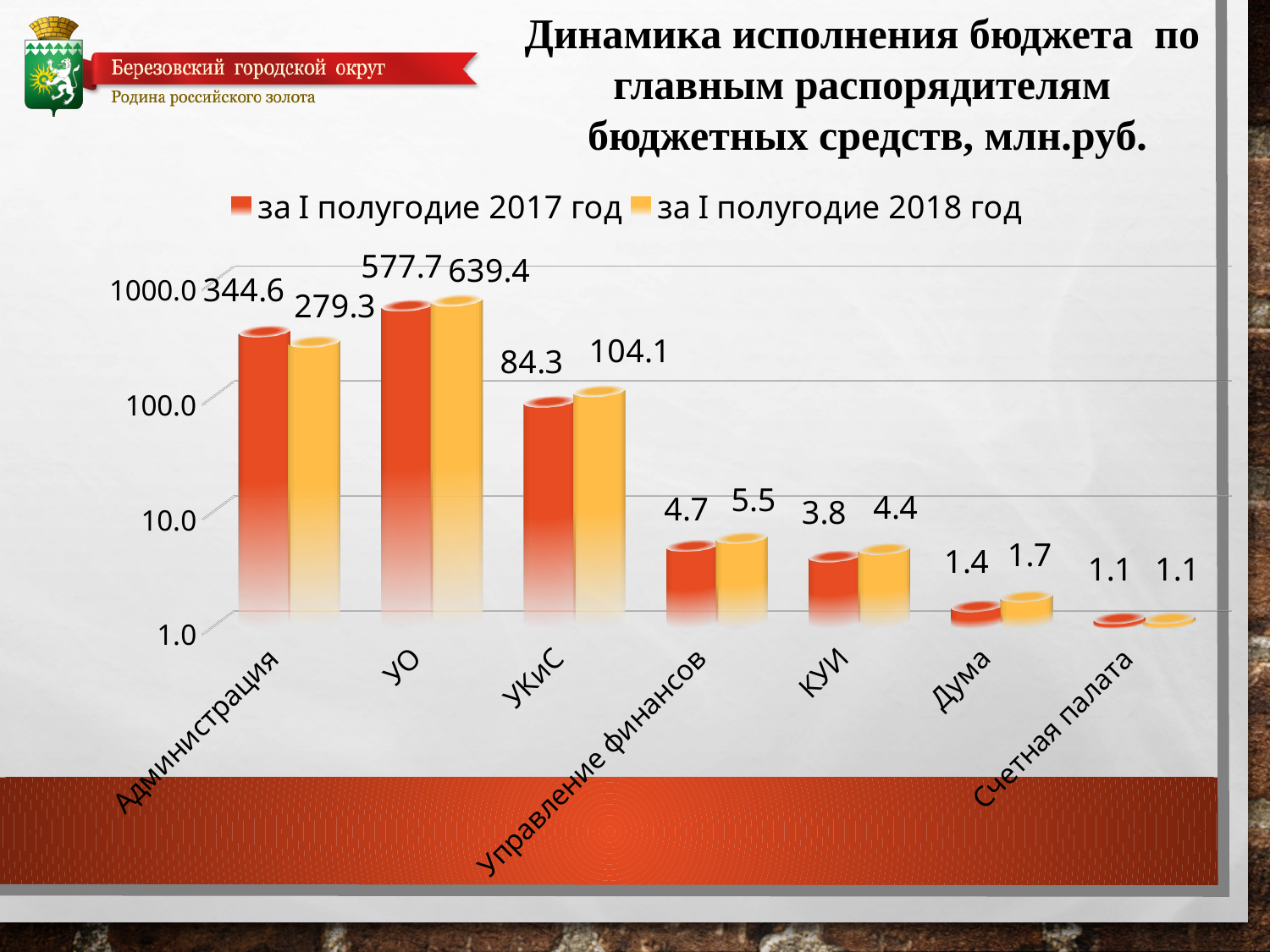
Which category has the highest value for за I полугодие 2018 год? УО What is the value for Дума for за I полугодие 2017 год? 1.4 Which category has the lowest value for за I полугодие 2017 год? Счетная палата What is the difference between the за I полугодие 2018 год and за I полугодие 2017 год values for УО? 61.7 What is the value for Администрация for за I полугодие 2017 год? 344.6 What is the difference between the за I полугодие 2018 год and за I полугодие 2017 год values for Управление финансов? 0.8 What is the value for УО for за I полугодие 2018 год? 639.4 What kind of chart is shown on the slide? Bar chart What is the value for УКиС for за I полугодие 2018 год? 104.1 How many series does the legend list? 2 For Администрация, which is larger: the value for за I полугодие 2017 год or за I полугодие 2018 год? за I полугодие 2017 год How many categories are shown on the x axis? 7